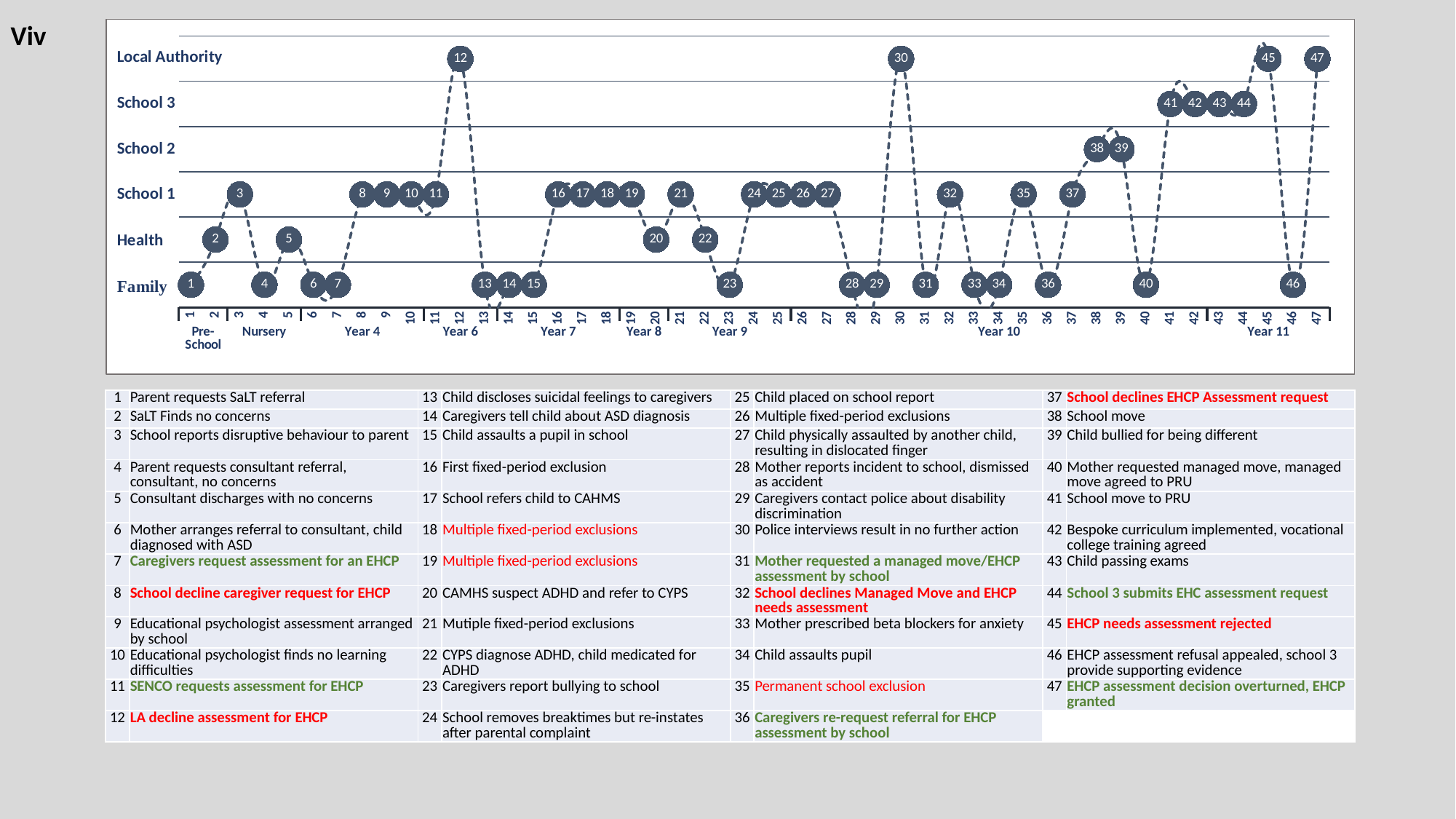
How many events are plotted on the School 2 row? 2 On which row of the chart is event 1 plotted? Family What is the highest event number plotted on the chart? 47 What kind of chart is shown on the slide? Line chart On which row of the chart is event 38 plotted? School 2 How many events are plotted on the Local Authority row? 4 Which row of the chart has the most events plotted on it? School 1 On which row of the chart is event 12 plotted? Local Authority On which row of the chart is event 20 plotted? Health On which row of the chart is event 41 plotted? School 3 Which school year label appears beneath event 12 on the x axis? Year 6